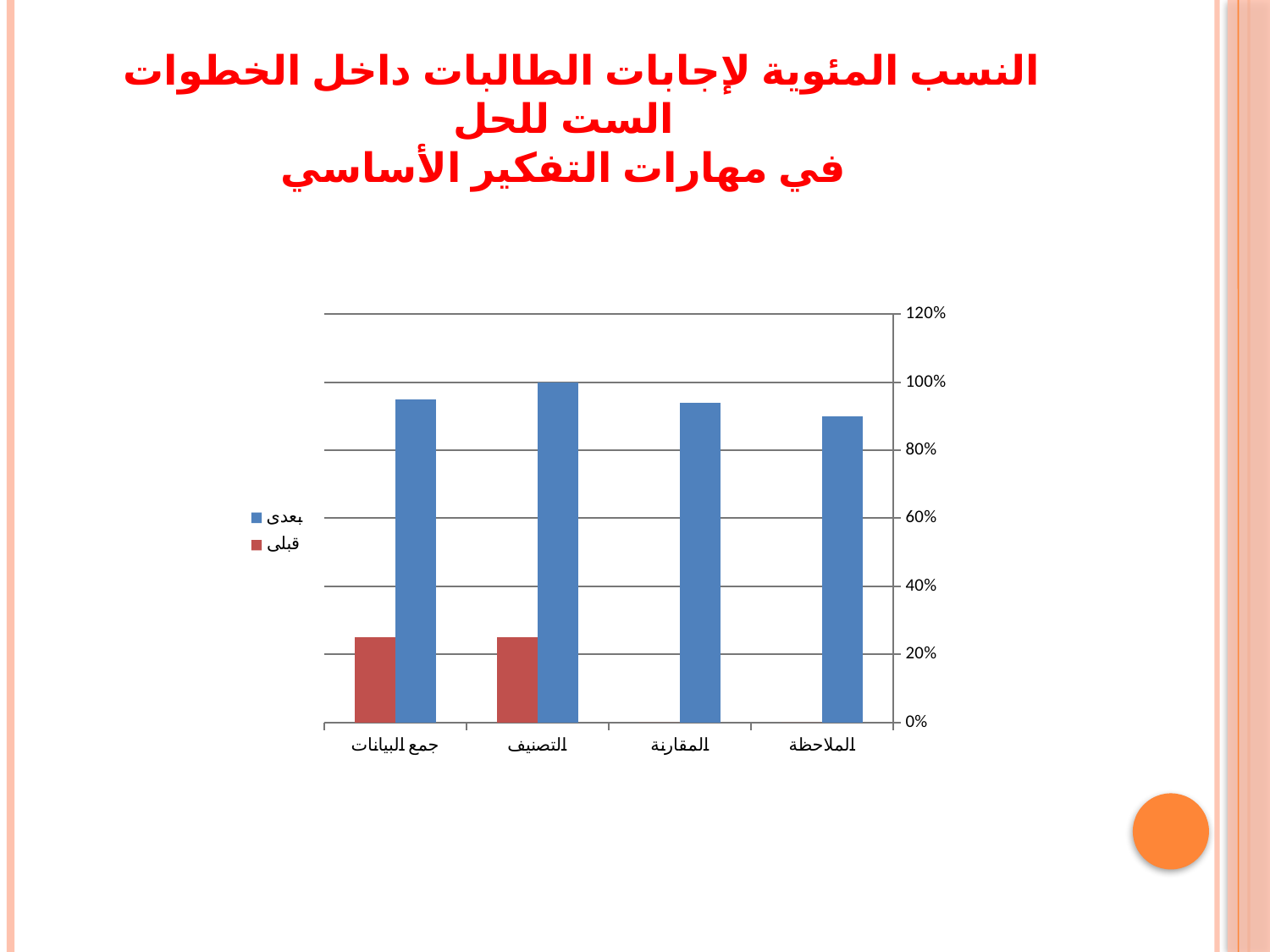
What kind of chart is shown on the slide? bar chart Is the بعدي value for المقارنة greater or less than 100%? less Which series is shown in red in the chart? قبلي Is the بعدي value for الملاحظة greater or less than 80%? greater How many series does the chart's legend list? 2 What is the value of the بعدي series for التصنيف? 100% Which is larger: the بعدي value for التصنيف or the بعدي value for الملاحظة? التصنيف How many categories are shown on the x axis of the chart? 4 Which category has the highest value in the بعدي series? التصنيف Which colour represents the بعدي series in the chart? blue Is the قبلي value for جمع البيانات greater or less than 40%? less